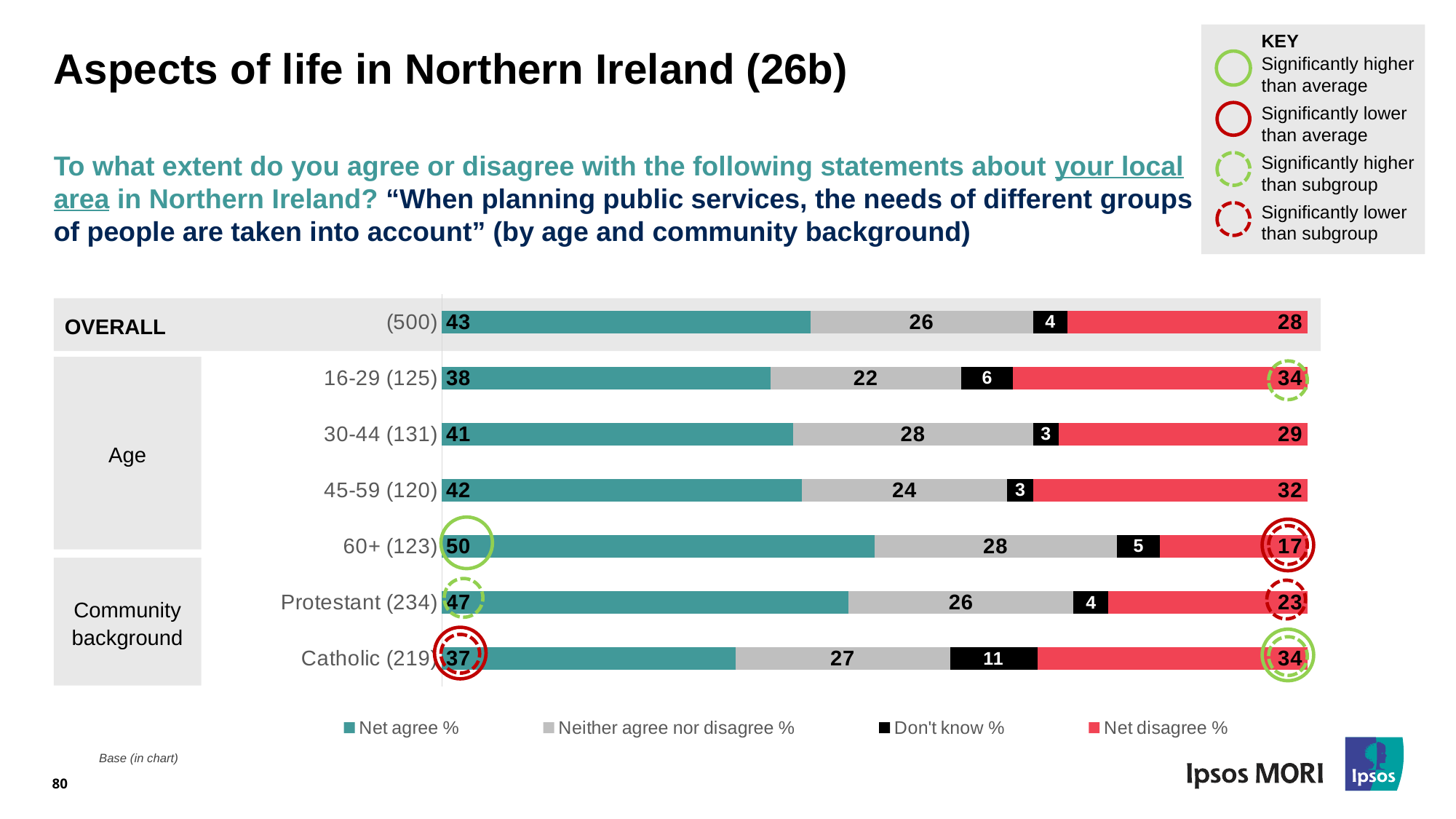
What is the difference between the Net agree % for Protestant (234) and Catholic (219)? 10 What is the Net agree % for the 60+ (123) group? 50 What is the Net disagree % for the OVERALL (500) row? 28 What is the Don't know % for Catholic (219)? 11 Which is larger, the Net disagree % for 16-29 (125) or for 30-44 (131)? 16-29 (125) How many groups (bars) are shown in the chart? 7 What kind of chart is shown on the slide? Stacked bar chart Which series is shown in black in the legend? Don't know % What is the total of the Net agree % and Net disagree % for 45-59 (120)? 74 Which group has the lowest Net disagree %? 60+ (123) How many series does the legend list? 4 Which group has the highest Net agree %? 60+ (123)